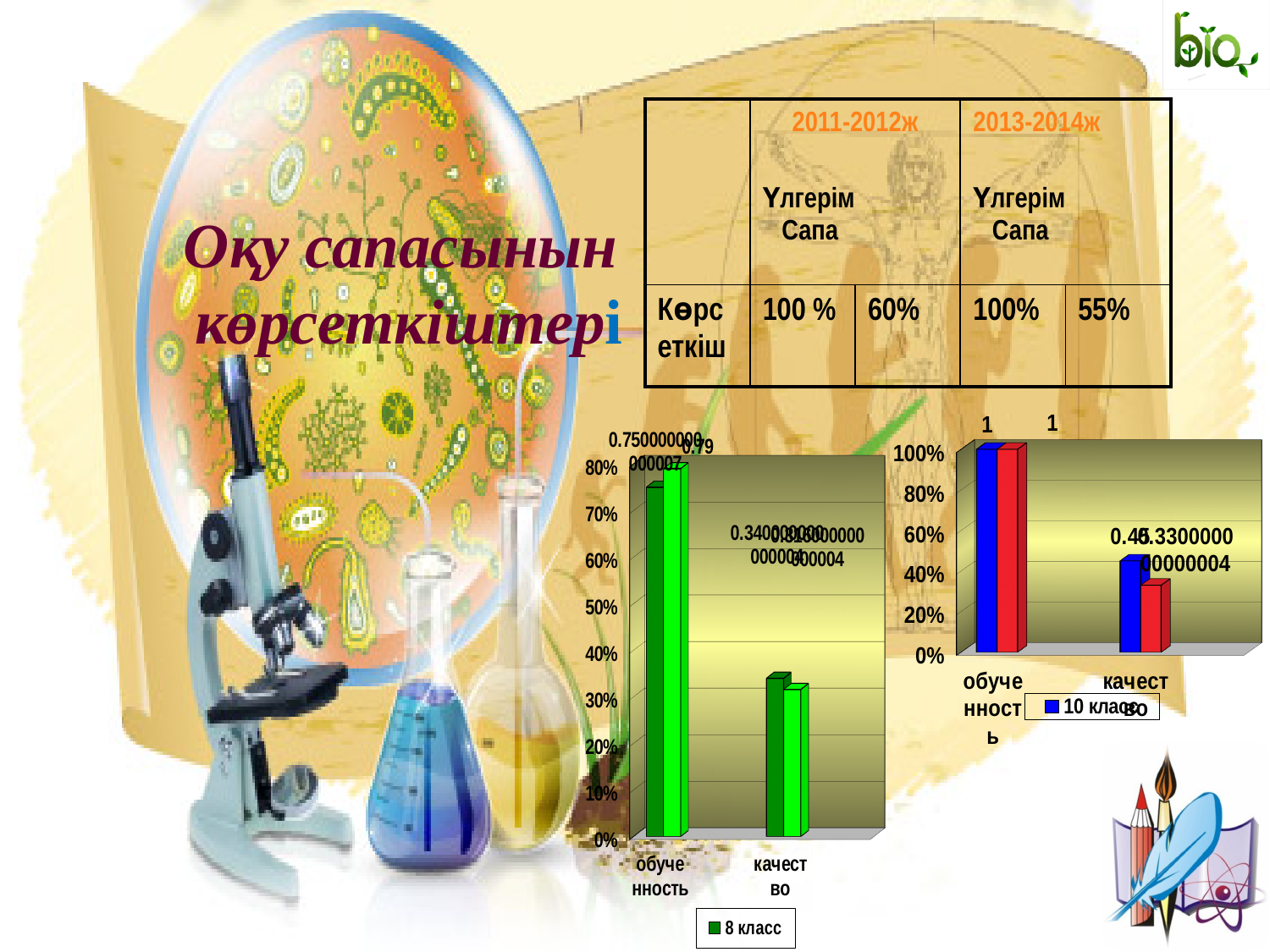
What entry does the legend of the left chart show? 8 класс In the left chart ('8 класс'), how many categories are shown on the x axis? 2 In the left chart ('8 класс'), which category has the highest bars? обученность In the right chart ('10 класс'), which category has the higher bars, обученность or качество? обученность In the right chart ('10 класс'), what value is printed above the обученность bars? 1 In the right chart ('10 класс'), is the blue bar for качество greater or less than 60%? less In the left chart ('8 класс'), which category has the lowest bars? качество In the right chart ('10 класс'), how many categories are shown on the x axis? 2 In the left chart ('8 класс'), are the values for качество greater or less than 40%? less What kind of chart is the right chart labelled '10 класс'? bar chart In the left chart ('8 класс'), are the values for обученность greater or less than 70%? greater What kind of chart is the left chart labelled '8 класс'? bar chart